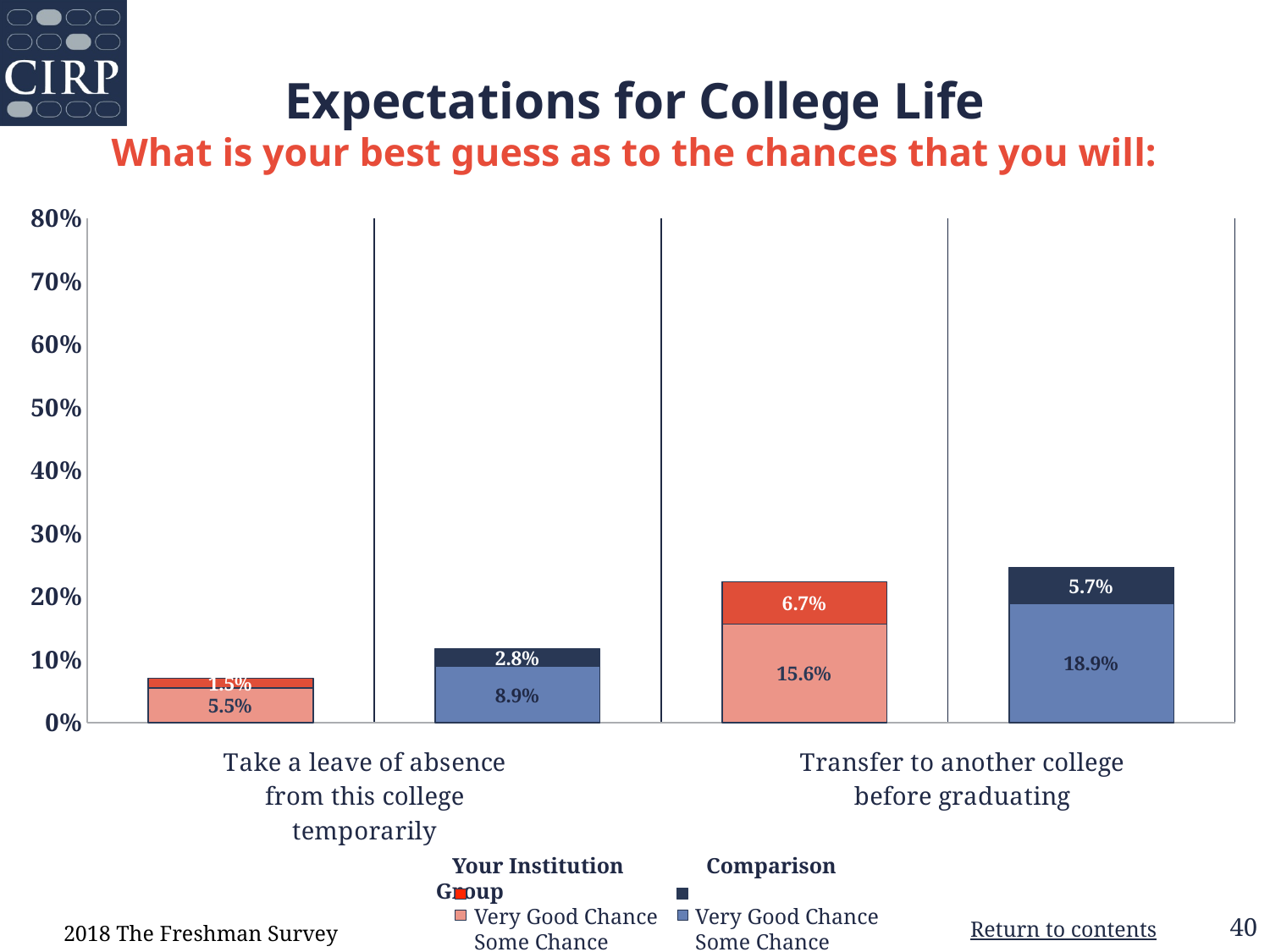
What kind of chart is shown on the slide? Stacked bar chart What is the total stacked value (Very Good Chance plus Some Chance) for the Comparison Group on taking a leave of absence from this college temporarily? 11.7% For a Very Good Chance of transferring to another college before graduating, which is larger: Your Institution or the Comparison Group? Your Institution Is the total stacked bar for the Comparison Group on transferring to another college before graduating greater or less than 20%? greater What percentage of the Comparison Group said there is a Very Good Chance they will take a leave of absence from this college temporarily? 2.8% What percentage of the Comparison Group said there is Some Chance they will transfer to another college before graduating? 18.9% Which of the two expectations has the highest Some Chance value for the Comparison Group? Transfer to another college before graduating What is the total stacked value (Very Good Chance plus Some Chance) for Your Institution on transferring to another college before graduating? 22.3% What is the difference between the Comparison Group's and Your Institution's Some Chance values for transferring to another college before graduating? 3.3% How many series does the legend list? 4 What percentage of students at Your Institution said there is Some Chance they will transfer to another college before graduating? 15.6% What percentage of students at Your Institution said there is a Very Good Chance they will take a leave of absence from this college temporarily? 1.5%